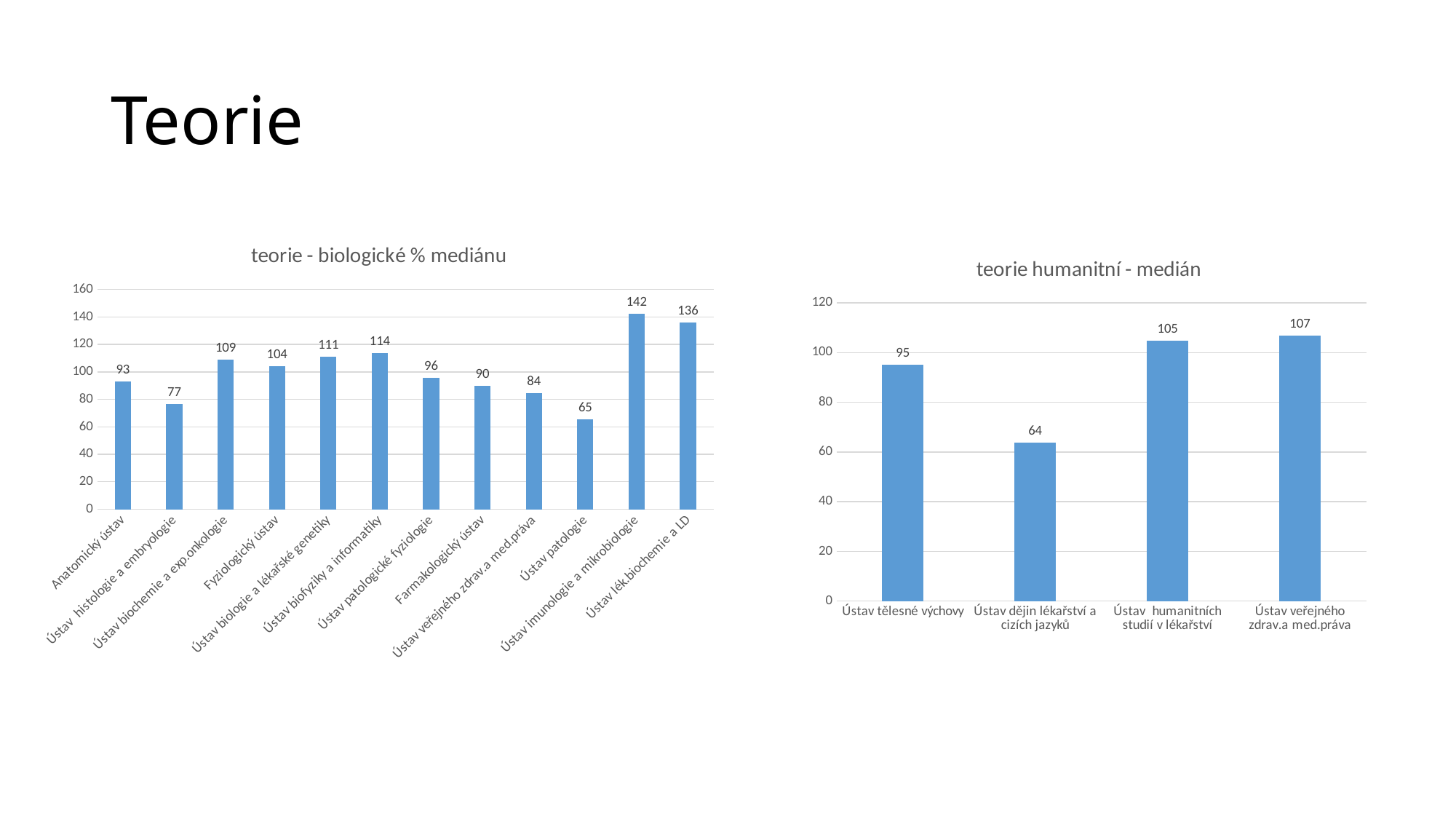
In the chart 'teorie - biologické % mediánu', which category has the highest value? Ústav imunologie a mikrobiologie In the chart 'teorie humanitní - medián', what is the difference between the values for Ústav tělesné výchovy and Ústav dějin lékařství a cizích jazyků? 31 In the chart 'teorie - biologické % mediánu', what is the difference between the values for Ústav imunologie a mikrobiologie and Ústav lék.biochemie a LD? 6 In the chart 'teorie - biologické % mediánu', what is the value for Fyziologický ústav? 104 In the chart 'teorie - biologické % mediánu', which category has the lowest value? Ústav patologie In the chart 'teorie humanitní - medián', which category has the highest value? Ústav veřejného zdrav.a med.práva In the chart 'teorie - biologické % mediánu', how many categories are shown? 12 In the chart 'teorie humanitní - medián', how many categories are shown? 4 What kind of chart is 'teorie humanitní - medián'? bar chart In the chart 'teorie - biologické % mediánu', what is the value for Ústav veřejného zdrav.a med.práva? 84 In the chart 'teorie humanitní - medián', what is the value for Ústav dějin lékařství a cizích jazyků? 64 In the chart 'teorie - biologické % mediánu', which is larger: the value for Ústav biofyziky a informatiky or the value for Ústav biochemie a exp.onkologie? Ústav biofyziky a informatiky